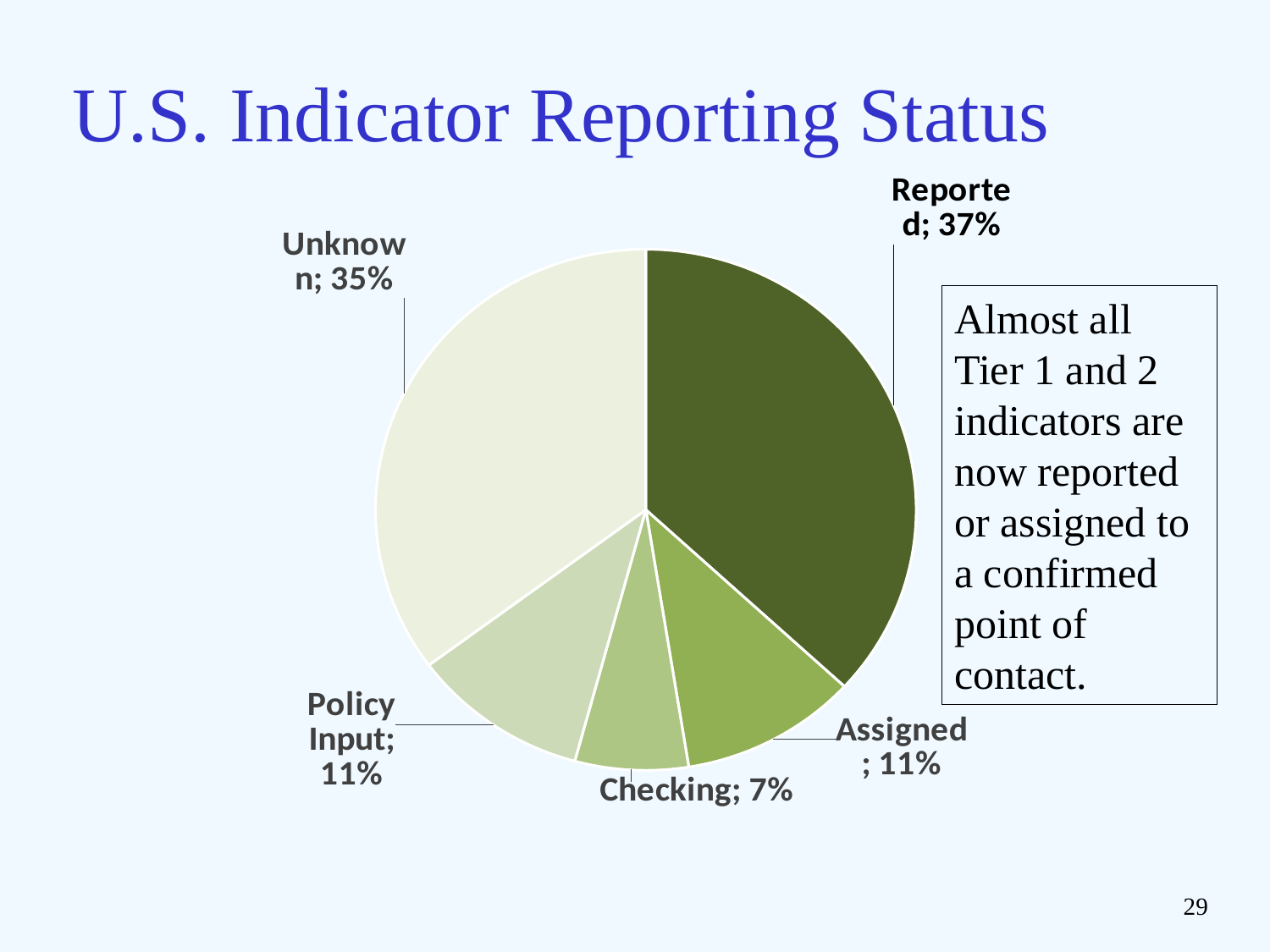
What share of the pie is labelled Reported? 37% What share of the pie is labelled Checking? 7% What is the difference in percentage points between the Reported and Unknown slices? 2 What kind of chart is shown on the slide? pie chart Which category has the largest slice of the pie? Reported How many slices does the pie chart have? 5 What share of the pie is labelled Assigned? 11% Which is larger, the Unknown slice or the Checking slice? Unknown Which category has the smallest slice of the pie? Checking What is the title of the slide containing the pie chart? U.S. Indicator Reporting Status